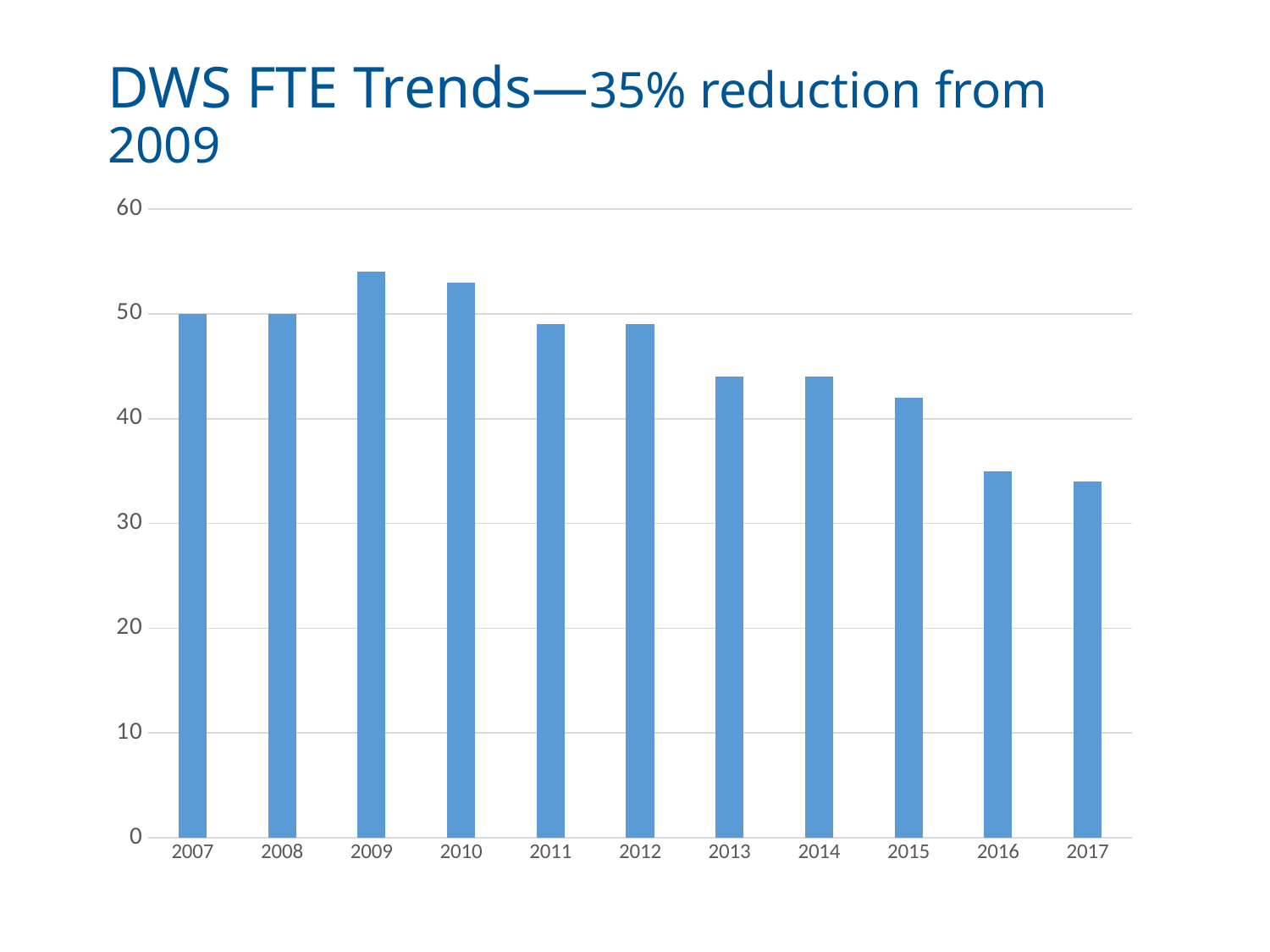
Is the value for 2016 greater or less than 40? less What is the value for 2008? 50 Do the values generally rise or fall from 2009 to 2017? fall Is the value for 2009 greater or less than 50? greater Which is larger, the value for 2009 or the value for 2016? 2009 Is the value for 2013 greater or less than 50? less What type of chart is shown on the slide? bar chart Which is larger, the value for 2017 or the value for 2012? 2012 How many years are shown on the x axis of the chart? 11 What is the title of the chart on the slide? DWS FTE Trends—35% reduction from 2009 What is the value for 2007? 50